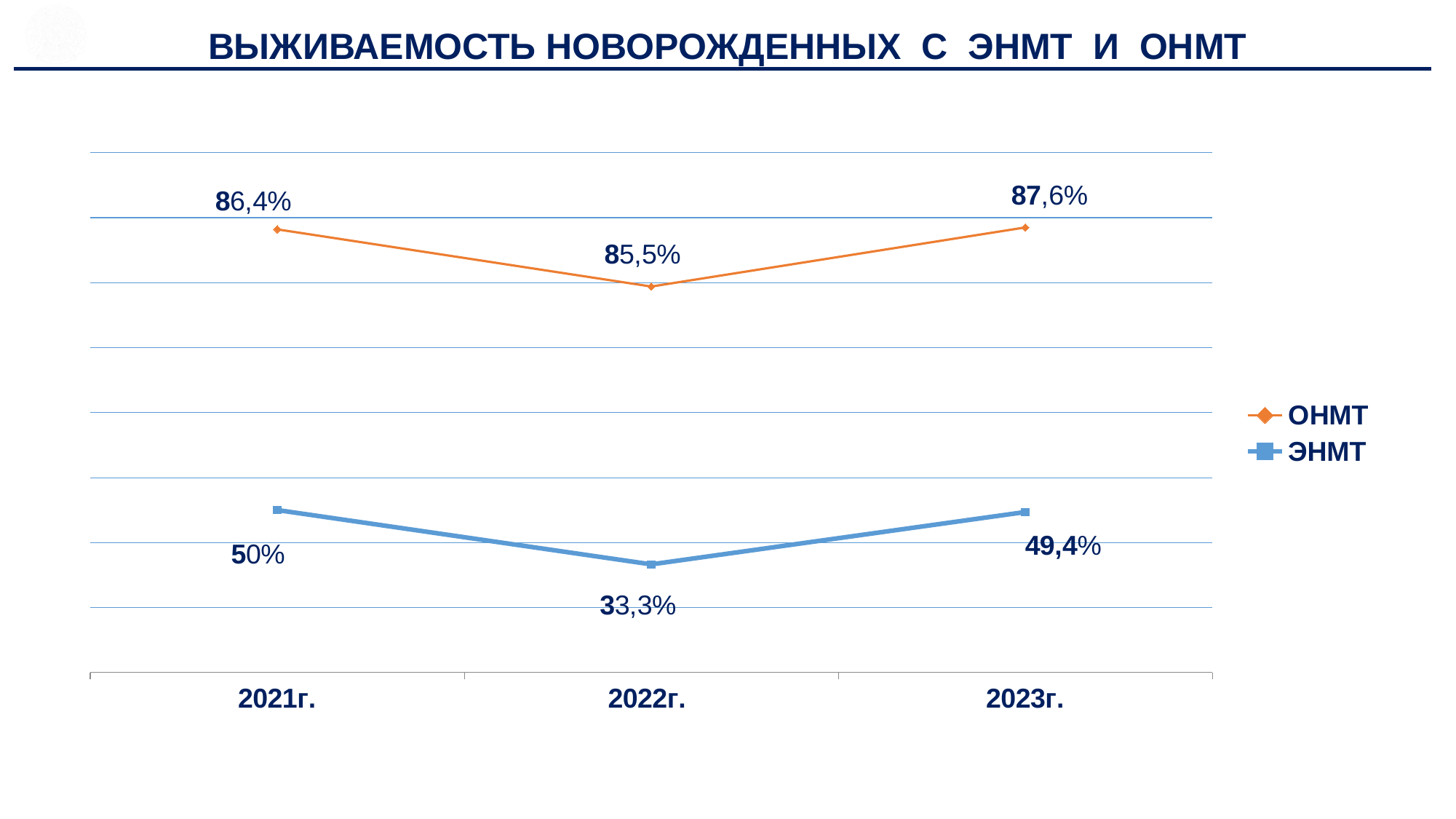
What is the difference between the ЭНМТ values in 2021г. and 2022г.? 16,7% How many years are shown on the x axis? 3 Which is larger in 2021г., the ОНМТ value or the ЭНМТ value? ОНМТ In which year is the ЭНМТ value lowest? 2022г. In which year is the ОНМТ value highest? 2023г. What is the value for ОНМТ in 2023г.? 87,6% What is the difference between the ОНМТ and ЭНМТ values in 2023г.? 38,2% What is the value for ЭНМТ in 2021г.? 50% What is the value for ОНМТ in 2022г.? 85,5% How many series does the legend list? 2 What kind of chart is shown on the slide? line chart What is the value for ЭНМТ in 2023г.? 49,4%